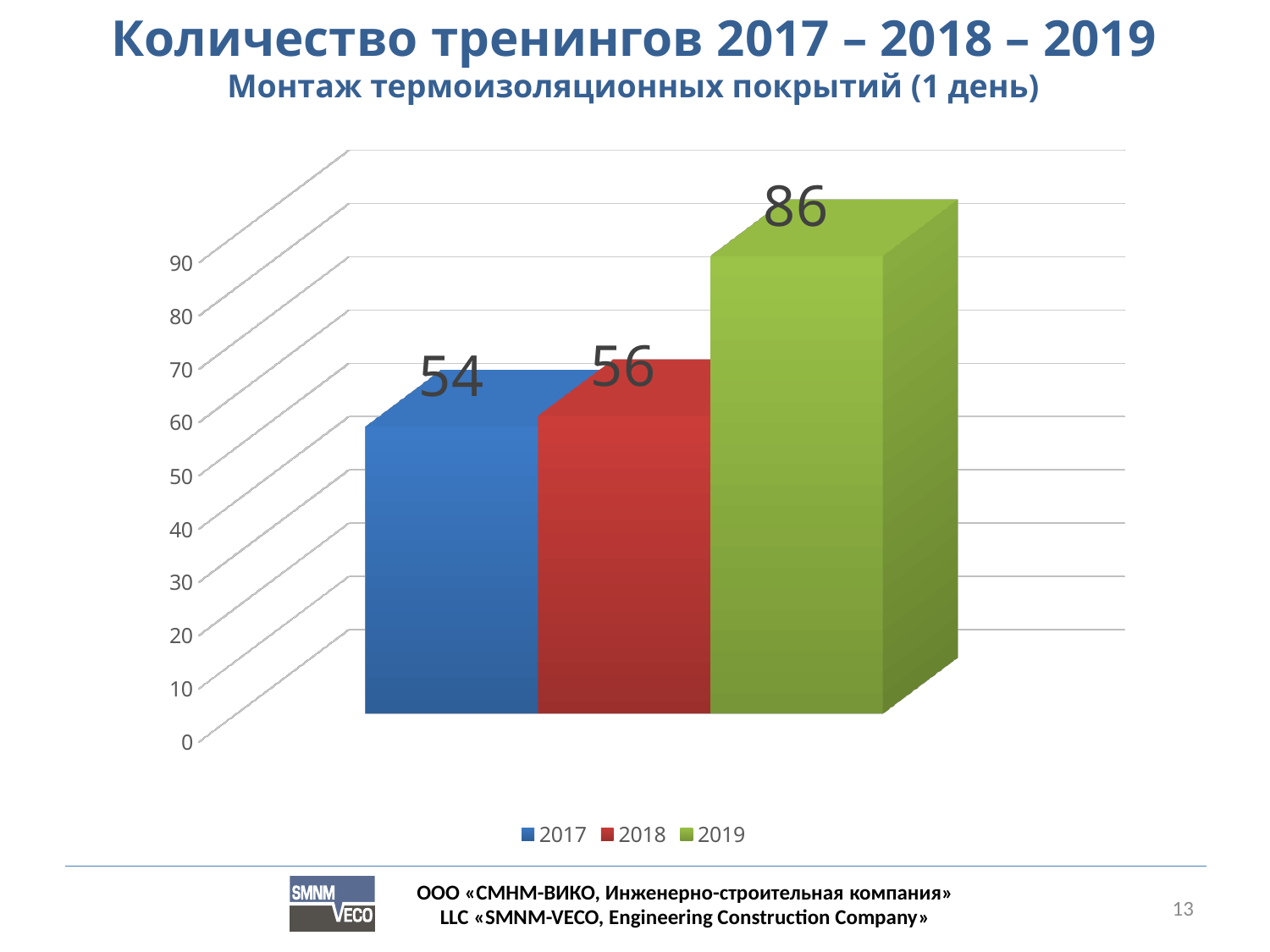
What kind of chart is shown on the slide? bar chart What colour is the bar for 2019? green What is the value for 2017? 54 What is the difference between the values for 2018 and 2017? 2 How many series does the legend list? 3 What is the difference between the values for 2019 and 2018? 30 Which is larger, the value for 2019 or the value for 2017? 2019 What is the value for 2018? 56 Which year has the highest value? 2019 Do the values rise or fall from 2017 to 2019? rise Which year has the lowest value? 2017 What is the value for 2019? 86